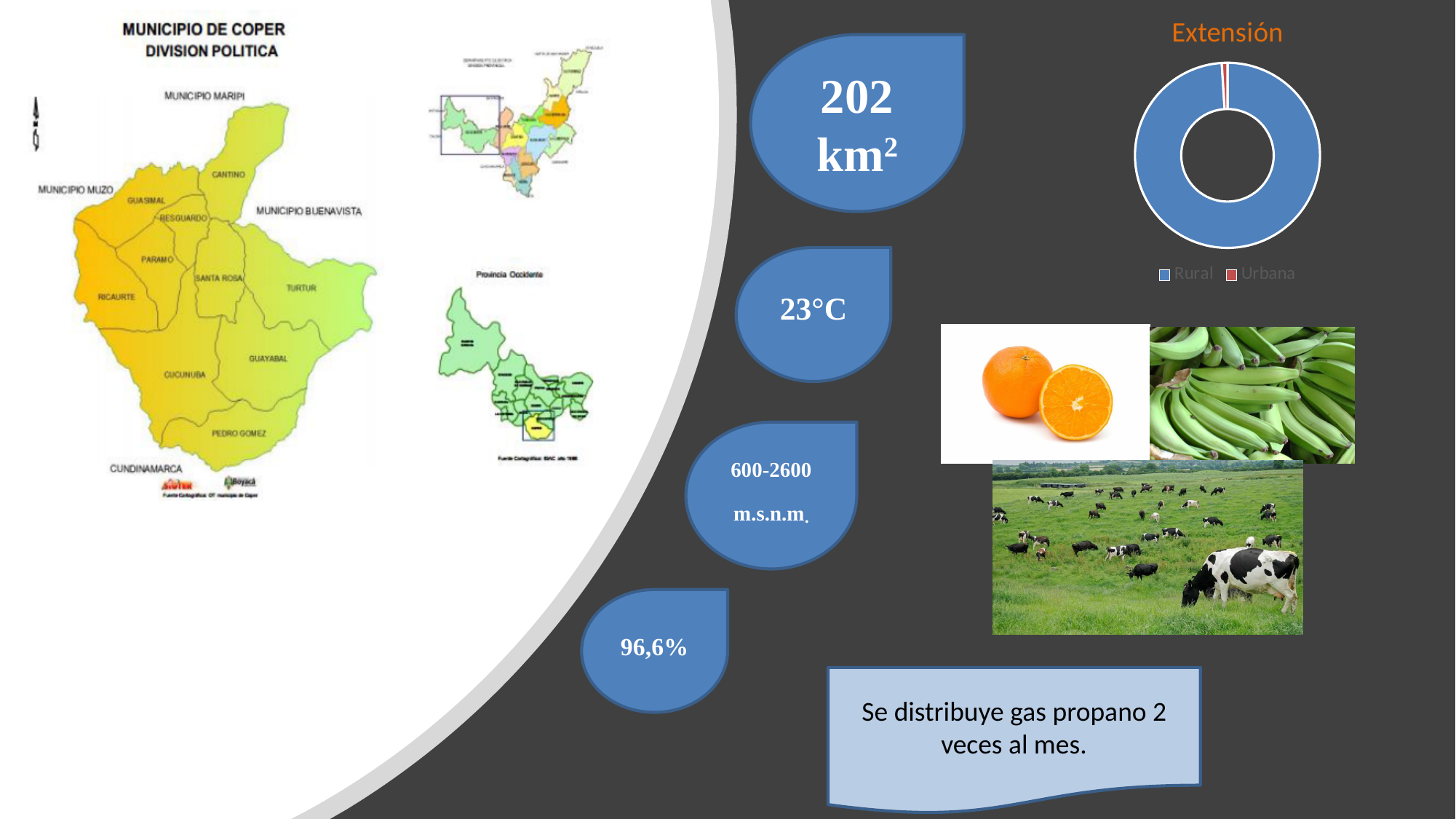
Which category takes up the smallest share of the "Extensión" chart? Urbana How many categories does the legend of the "Extensión" chart list? 2 What is the title of the chart on the right side of the slide? Extensión What colour represents Rural in the "Extensión" chart? blue In the "Extensión" chart, which is larger, Rural or Urbana? Rural What are the two legend entries of the "Extensión" chart? Rural and Urbana Which category takes up the largest share of the "Extensión" chart? Rural What kind of chart is shown under the title "Extensión"? doughnut chart